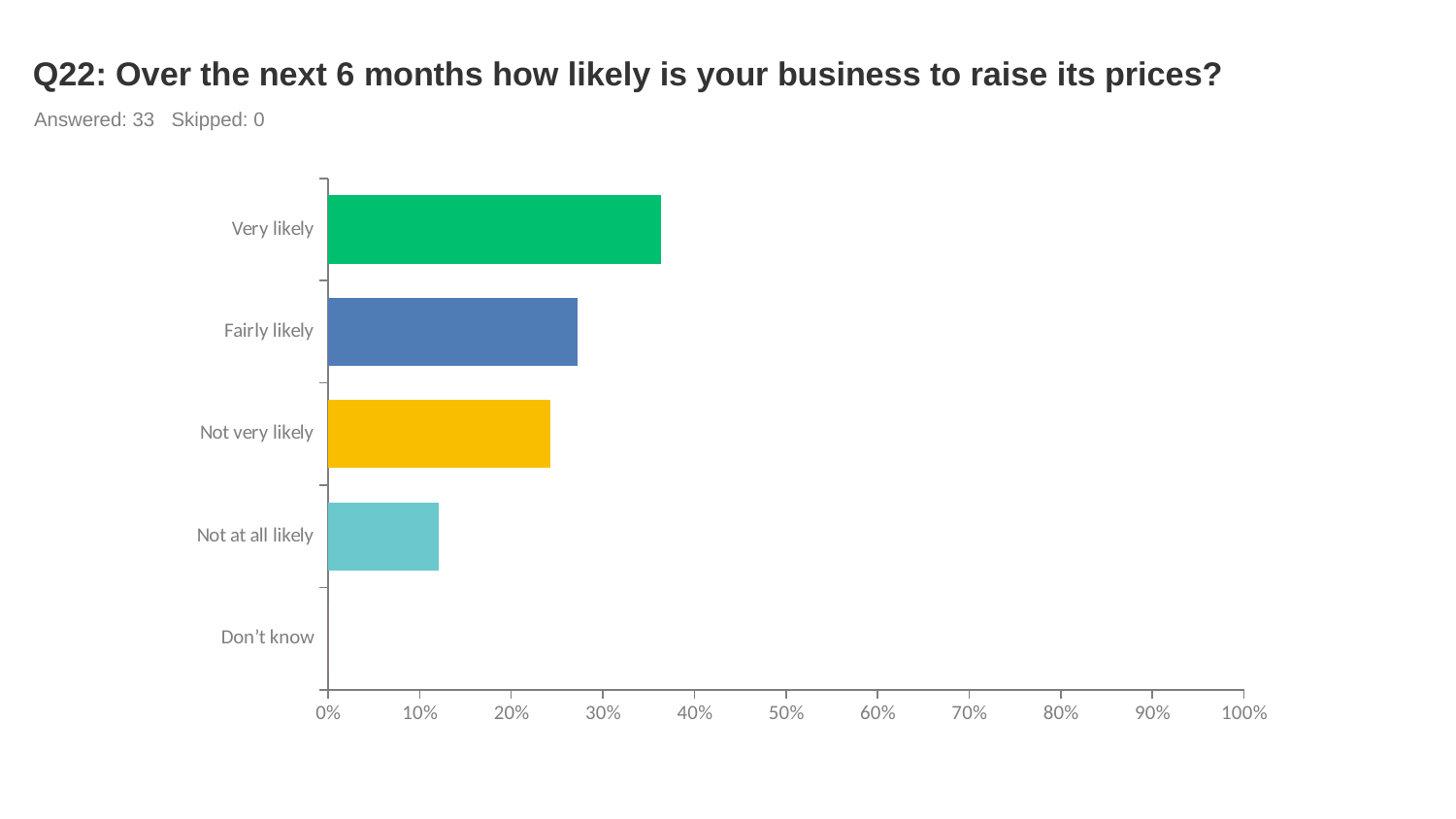
What kind of chart is shown on the slide? Bar chart Which is larger, the value for Very likely or the value for Fairly likely? Very likely Which is larger, the value for Not very likely or the value for Not at all likely? Not very likely Which category has the highest value? Very likely Is the value for Not very likely greater or less than 20%? greater Is the value for Very likely greater or less than 30%? greater What is the value for Don't know? 0% Which category has the lowest value? Don't know Is the value for Not at all likely greater or less than 20%? less How many respondents answered the question shown on the slide? 33 How many categories are shown on the chart? 5